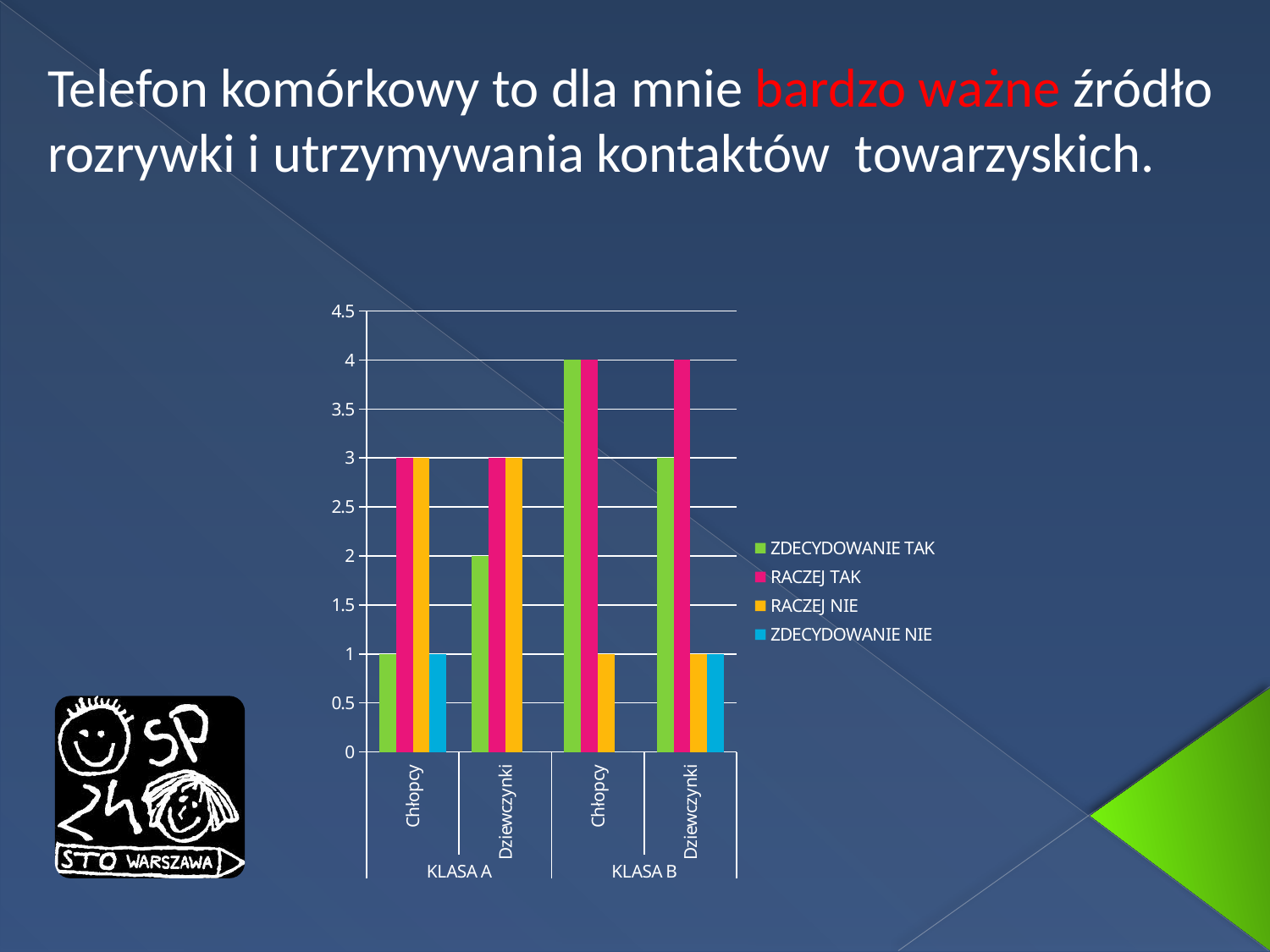
How many series does the legend list? 4 Which group has the lowest ZDECYDOWANIE TAK value? Chłopcy in KLASA A How many groups (categories) are shown on the x axis? 4 What is the difference between the ZDECYDOWANIE TAK values for Chłopcy in KLASA B and Chłopcy in KLASA A? 3 What kind of chart is shown on the slide? bar chart What is the value of RACZEJ NIE for Dziewczynki in KLASA B? 1 What is the value of RACZEJ TAK for Dziewczynki in KLASA A? 3 Which group has the highest ZDECYDOWANIE TAK value? Chłopcy in KLASA B Which legend entry is shown in green? ZDECYDOWANIE TAK Which is larger: RACZEJ NIE for Chłopcy in KLASA A or RACZEJ NIE for Chłopcy in KLASA B? Chłopcy in KLASA A What is the value of ZDECYDOWANIE TAK for Chłopcy in KLASA A? 1 What is the value of ZDECYDOWANIE TAK for Chłopcy in KLASA B? 4